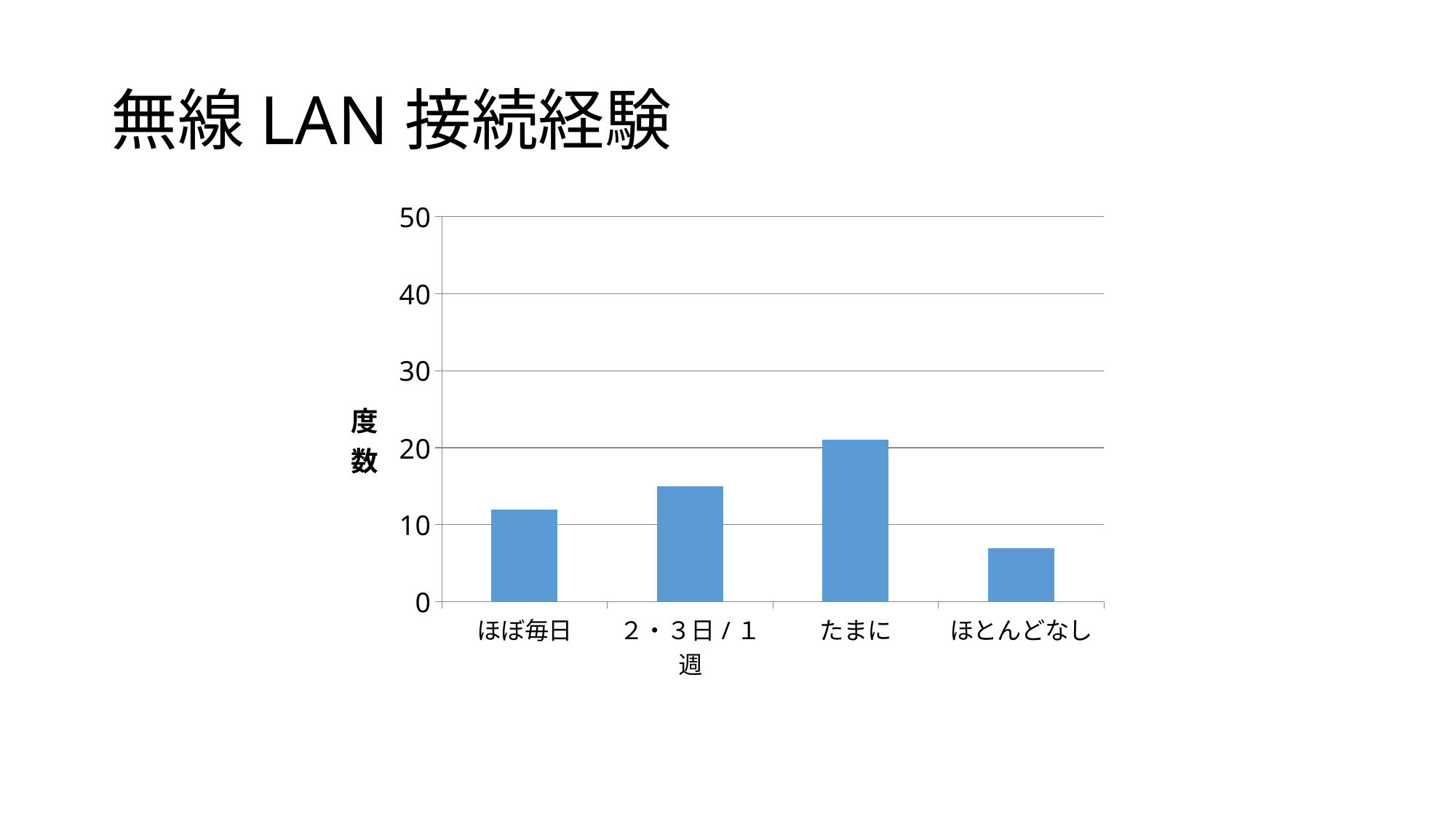
How many categories are shown on the x axis of the chart? 4 Is the value for 2・3日/1週 greater or less than 20? less Is the value for たまに greater or less than 30? less Which has a larger value, ほぼ毎日 or 2・3日/1週? 2・3日/1週 Which category has the lowest value in the chart? ほとんどなし What is the label on the vertical axis of the chart? 度数 Is the value for ほとんどなし greater or less than 10? less What kind of chart is shown on the slide? bar chart Which has a larger value, たまに or ほとんどなし? たまに What is the title of the slide containing the chart? 無線 LAN 接続経験 Which category has the highest value in the chart? たまに